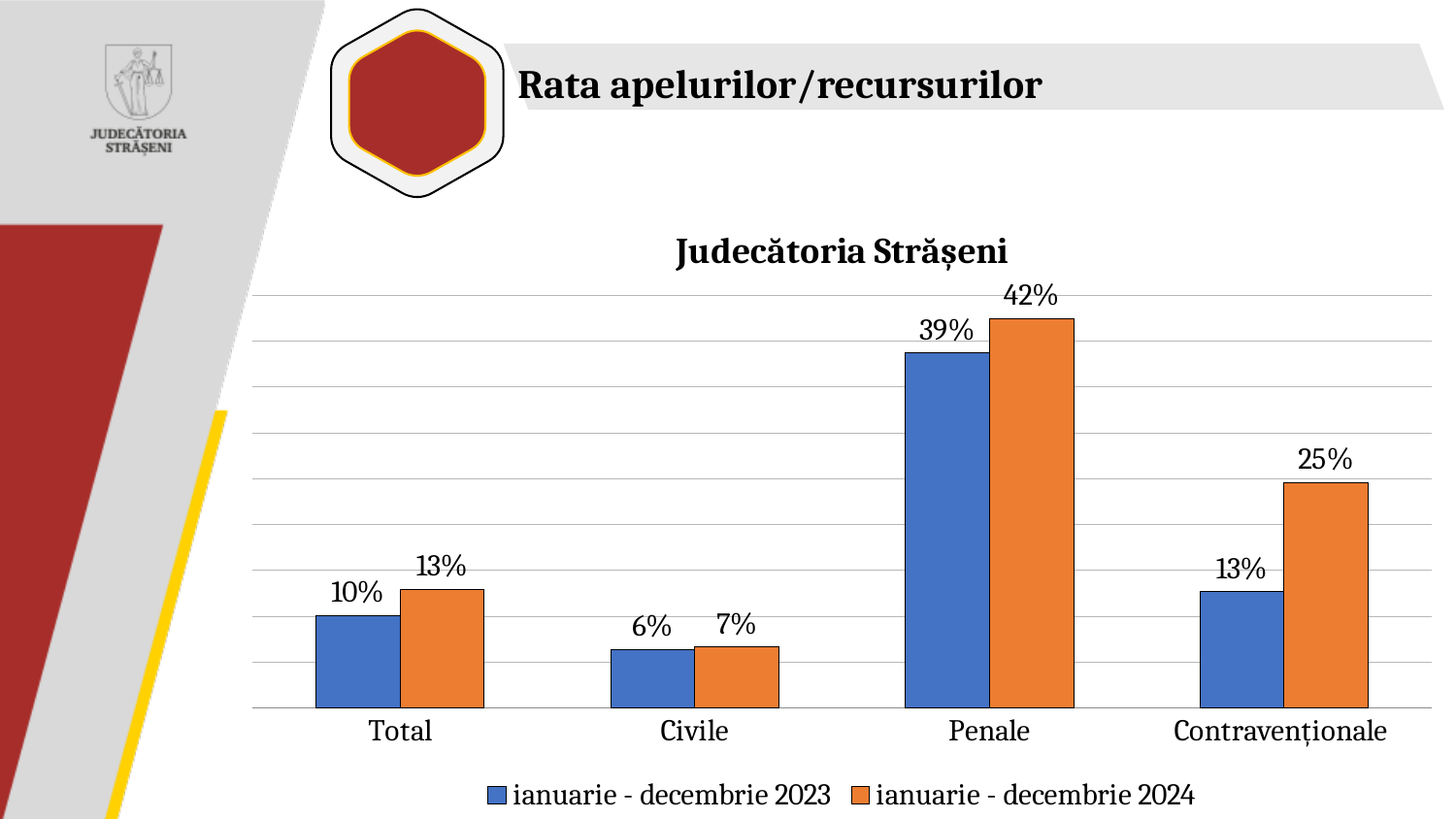
What is the value for Civile in the ianuarie - decembrie 2023 series? 6% How many categories are shown on the x axis? 4 What is the value for Contravenționale in the ianuarie - decembrie 2024 series? 25% Which category has the highest value in the ianuarie - decembrie 2024 series? Penale Which is larger for Total: the ianuarie - decembrie 2023 value or the ianuarie - decembrie 2024 value? ianuarie - decembrie 2024 What is the value for Penale in the ianuarie - decembrie 2024 series? 42% What is the difference between the 2024 and 2023 values for Contravenționale? 12% Which category has the lowest value in the ianuarie - decembrie 2023 series? Civile What is the value for Total in the ianuarie - decembrie 2023 series? 10% What kind of chart is shown on the slide? Bar chart How many series does the legend list? 2 What is the difference between the 2024 and 2023 values for Penale? 3%